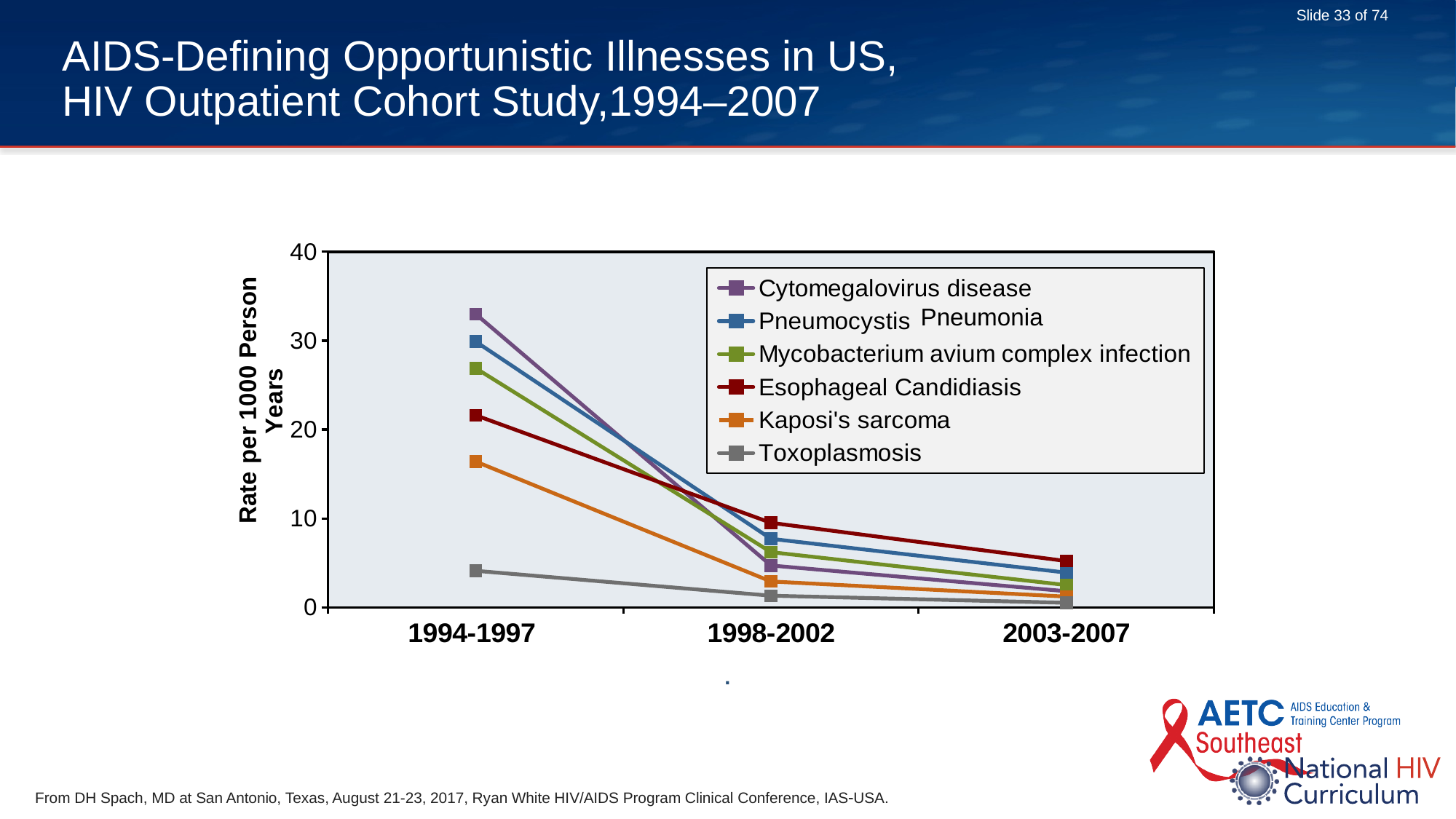
Is the rate for Cytomegalovirus disease in 1994-1997 greater or less than 30? greater Which illness has the highest rate in 2003-2007? Esophageal Candidiasis Which is larger in 1998-2002, the rate for Esophageal Candidiasis or for Cytomegalovirus disease? Esophageal Candidiasis What is the label of the y axis? Rate per 1000 Person Years How many series does the legend list? 6 Is the rate for Kaposi's sarcoma in 1994-1997 greater or less than 20? less What kind of chart is shown on the slide? line chart Which illness has the lowest rate in 1994-1997? Toxoplasmosis Do the rates for Pneumocystis Pneumonia rise or fall from 1994-1997 to 2003-2007? fall Which illness has the highest rate in 1994-1997? Cytomegalovirus disease Is the rate for Toxoplasmosis in 1994-1997 greater or less than 10? less How many time periods are shown on the x axis? 3